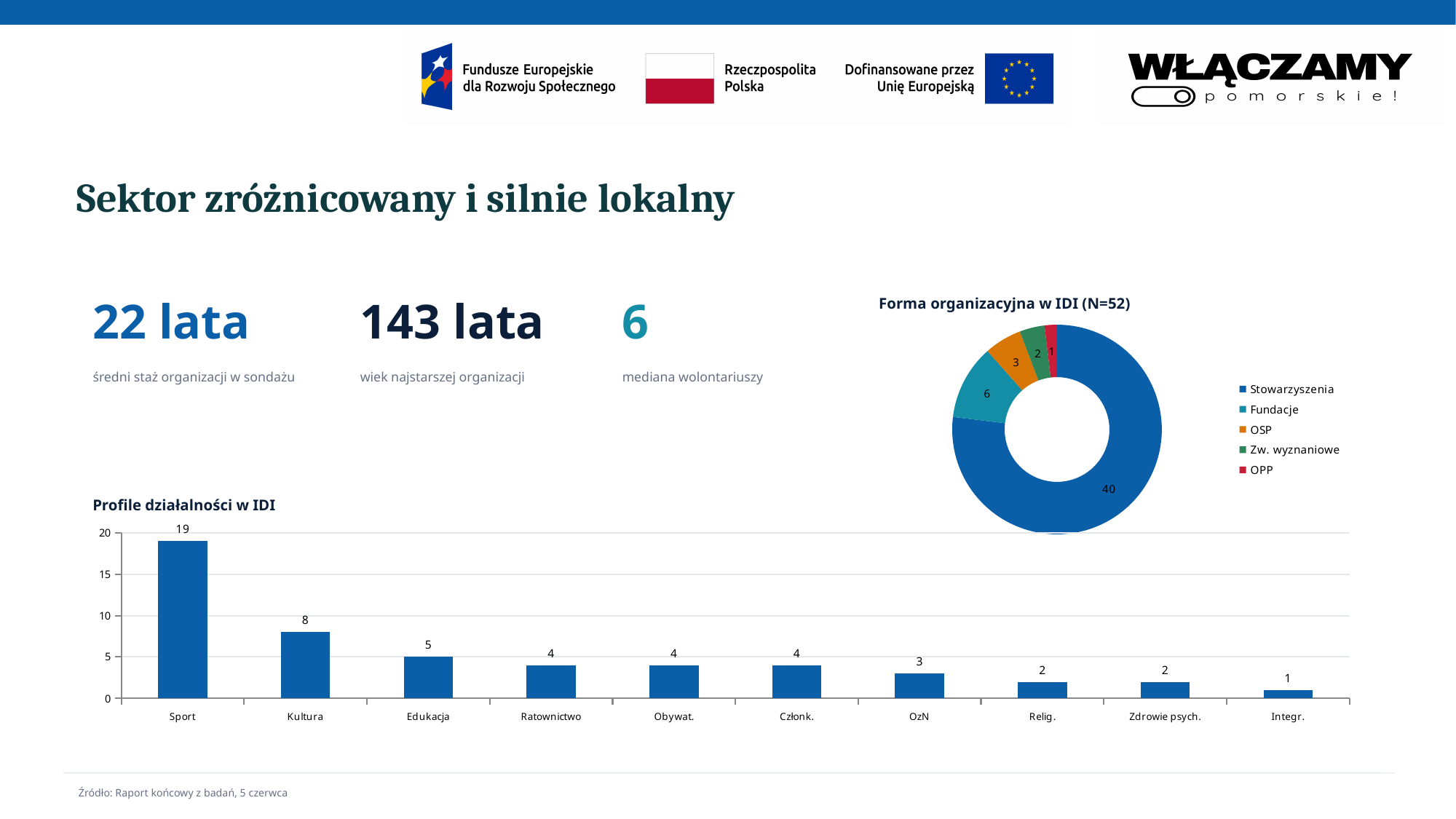
In the 'Profile działalności w IDI' chart, which category has the highest value? Sport In the 'Forma organizacyjna w IDI (N=52)' chart, which category has the largest share? Stowarzyszenia In the 'Forma organizacyjna w IDI (N=52)' chart, what is the difference between Stowarzyszenia and OSP? 37 How many categories are shown in the 'Profile działalności w IDI' chart? 10 In the 'Profile działalności w IDI' chart, which category has the lowest value? Integr. In the 'Profile działalności w IDI' chart, what is the value for Sport? 19 In the 'Profile działalności w IDI' chart, which is larger, Edukacja or OzN? Edukacja How many entries does the legend of the 'Forma organizacyjna w IDI (N=52)' chart list? 5 In the 'Profile działalności w IDI' chart, what is the difference between Sport and Kultura? 11 In the 'Profile działalności w IDI' chart, what is the value for Kultura? 8 What kind of chart is 'Profile działalności w IDI'? Bar chart In the 'Forma organizacyjna w IDI (N=52)' chart, what is the value for Fundacje? 6